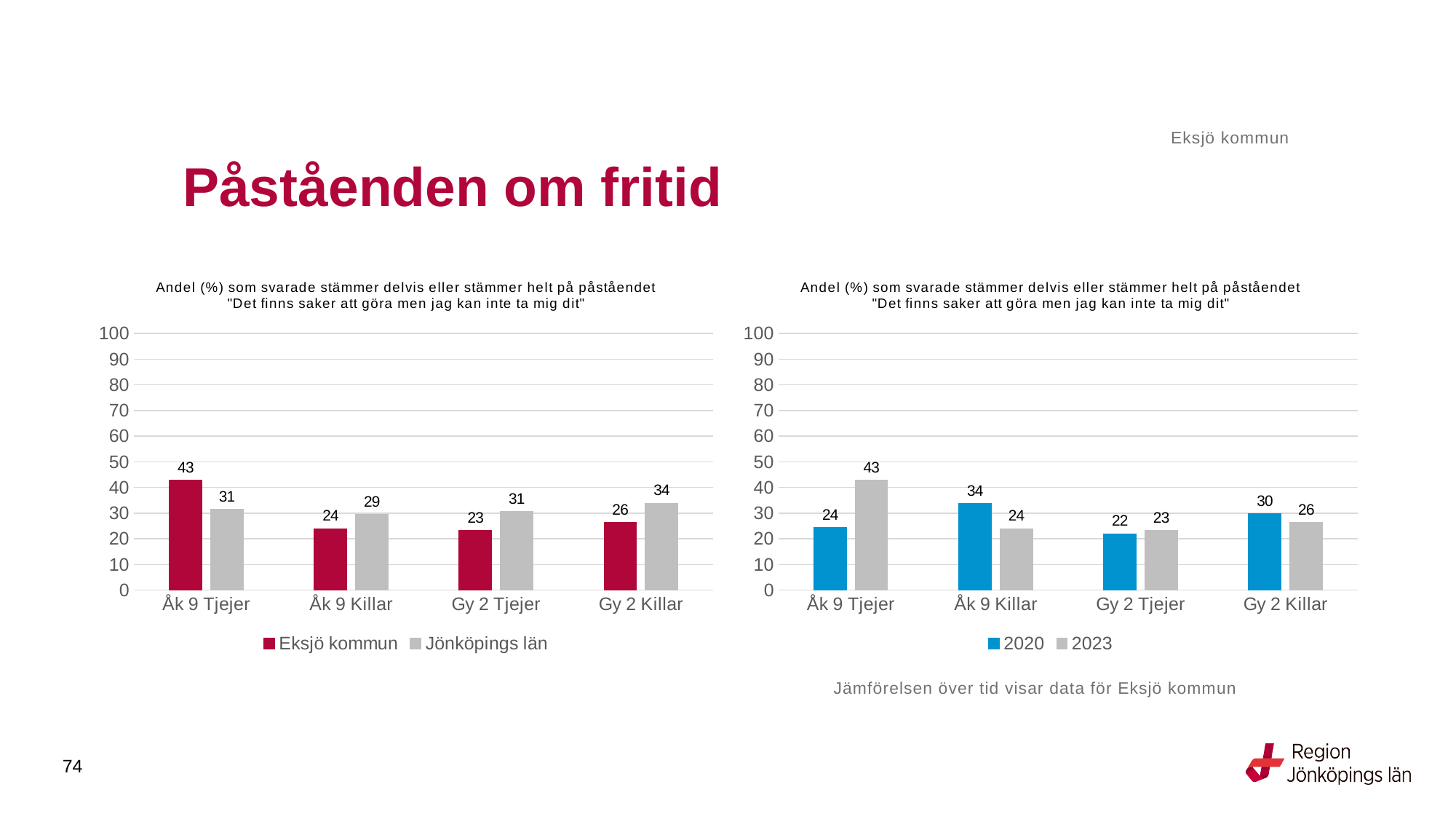
What kind of chart is the left chart? Bar chart In the left chart, which category has the highest value for Eksjö kommun? Åk 9 Tjejer How many series does the legend of the right chart list? 2 In the right chart, what is the difference between 2020 and 2023 for Åk 9 Killar? 10 In the right chart, what is the value for 2020 for Gy 2 Killar? 30 In the left chart, what is the value for Eksjö kommun for Åk 9 Tjejer? 43 In the left chart, what is the difference between Eksjö kommun and Jönköpings län for Åk 9 Tjejer? 12 In the left chart, what is the value for Jönköpings län for Gy 2 Killar? 34 In the left chart, which category has the lowest value for Eksjö kommun? Gy 2 Tjejer In the left chart, which is larger for Åk 9 Killar: Eksjö kommun or Jönköpings län? Jönköpings län In the right chart, which category has the lowest value for 2020? Gy 2 Tjejer In the right chart, what is the value for 2023 for Åk 9 Tjejer? 43